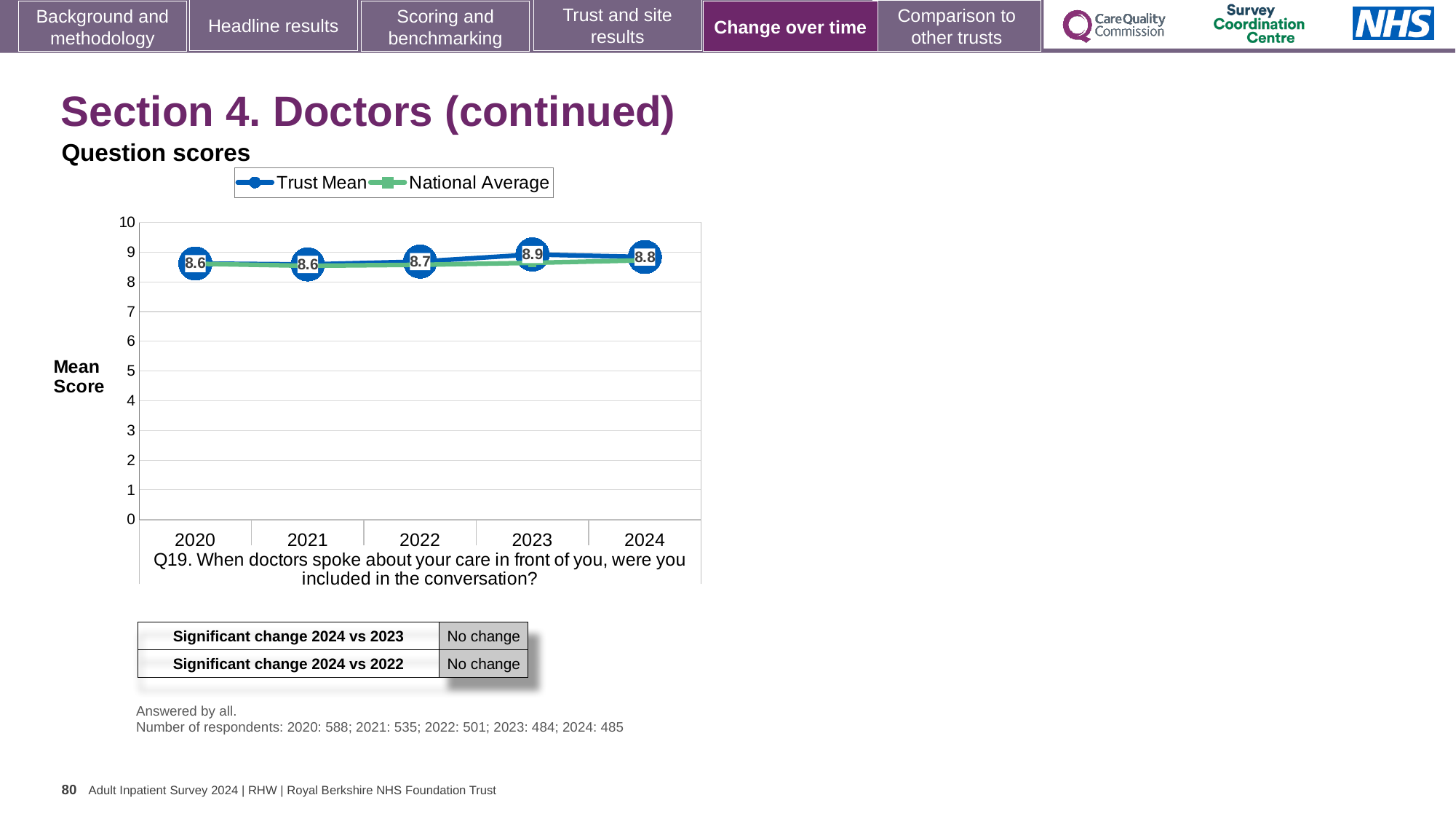
How many years are shown on the x axis of the chart? 5 In which year is the Trust Mean score highest? 2023 What is the Trust Mean score for 2024? 8.8 Which is larger, the Trust Mean score for 2023 or for 2021? 2023 What is the Trust Mean score for 2020? 8.6 How many series does the chart legend list? 2 What is the Trust Mean score for 2023? 8.9 Is the National Average value for 2024 greater or less than 8? greater What is the difference between the Trust Mean score in 2023 and in 2020? 0.3 What kind of chart is shown on the slide? Line chart What are the two series named in the chart legend? Trust Mean and National Average Does the Trust Mean score rise or fall from 2020 to 2023? Rise